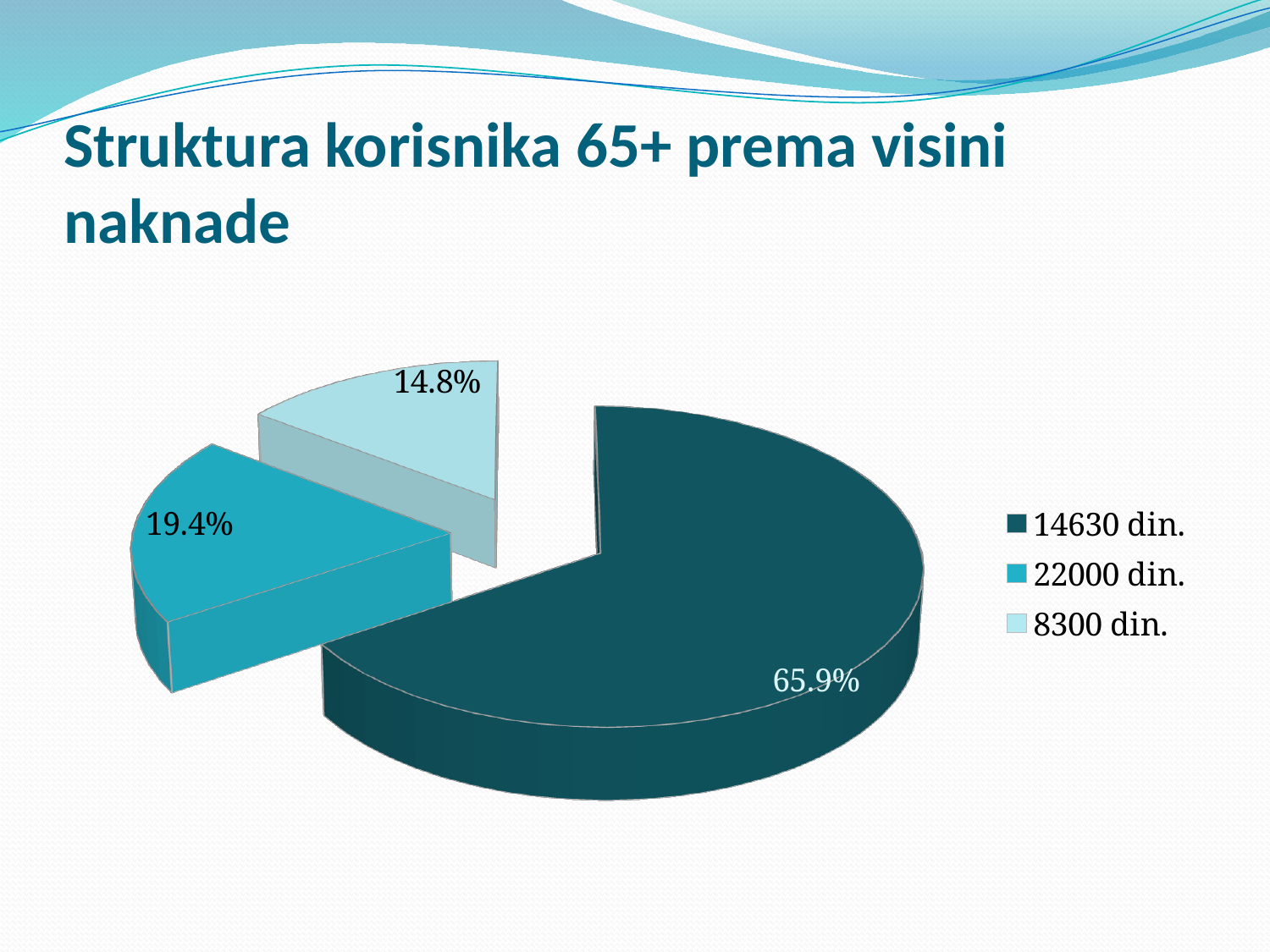
Which category has the smallest slice of the pie? 8300 din. What is the difference in percentage points between the 22000 din. slice and the 8300 din. slice? 4.6 What is the difference in percentage points between the 14630 din. slice and the 22000 din. slice? 46.5 Which slice is larger, 22000 din. or 8300 din.? 22000 din. What share of the pie does the 14630 din. slice represent? 65.9% What is the title of the slide containing the chart? Struktura korisnika 65+ prema visini naknade What share of the pie does the 22000 din. slice represent? 19.4% Which legend entry is shown with the lightest colour? 8300 din. What kind of chart is shown on the slide? Pie chart Which category has the largest slice of the pie? 14630 din. What share of the pie does the 8300 din. slice represent? 14.8% How many slices does the pie chart have? 3